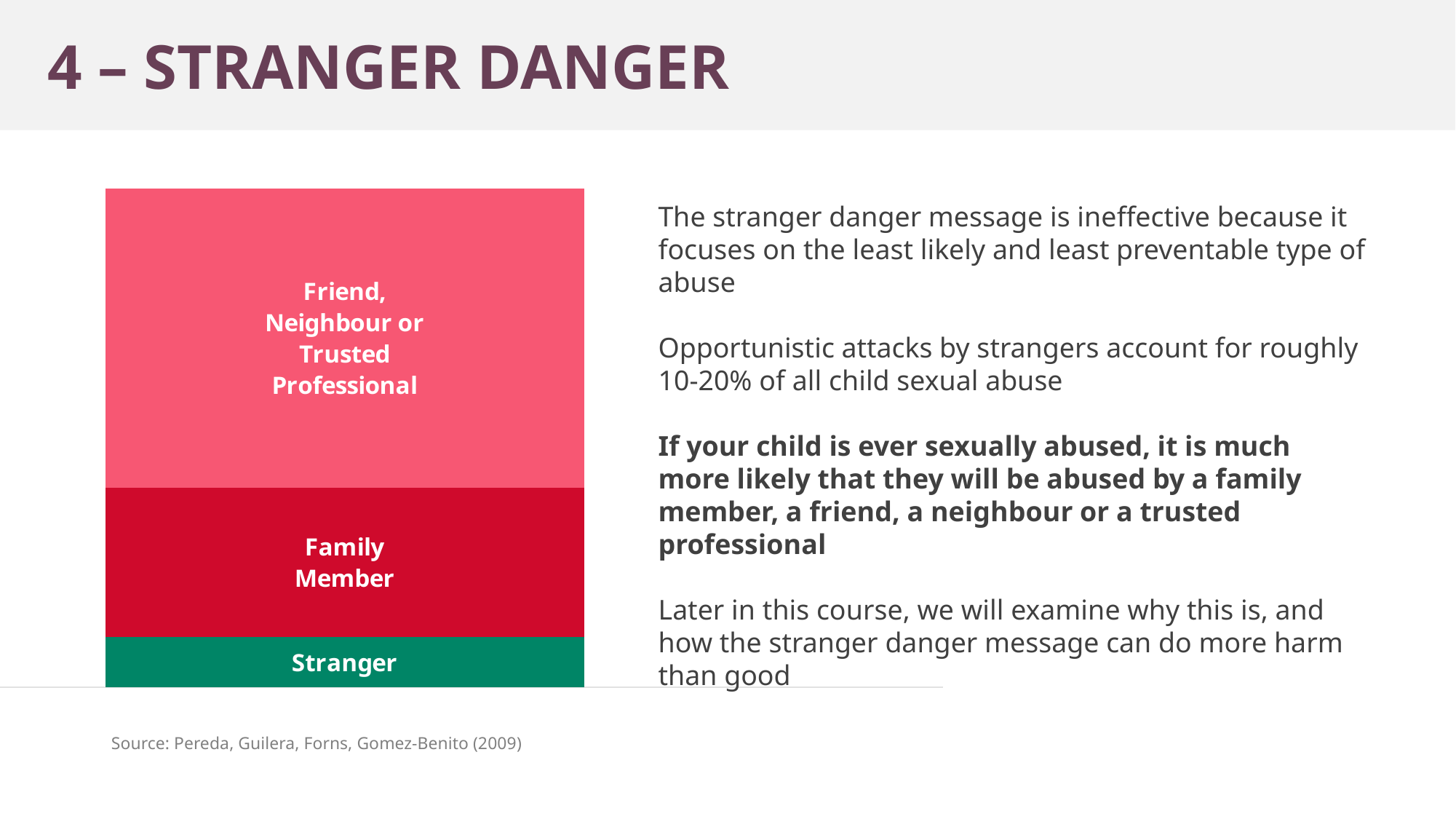
Which segment is larger, Family Member or Stranger? Family Member Which segment of the stacked bar is at the bottom? Stranger Which segment is larger, Friend, Neighbour or Trusted Professional or Family Member? Friend, Neighbour or Trusted Professional What kind of chart is shown on the slide? Stacked bar chart Which segment of the stacked bar is the smallest? Stranger Which segment of the stacked bar is the largest? Friend, Neighbour or Trusted Professional Which segment of the stacked bar is at the top? Friend, Neighbour or Trusted Professional What colour is the Stranger segment of the stacked bar? Green Which segment sits between the Friend, Neighbour or Trusted Professional segment and the Stranger segment? Family Member How many segments does the stacked bar on the slide have? 3